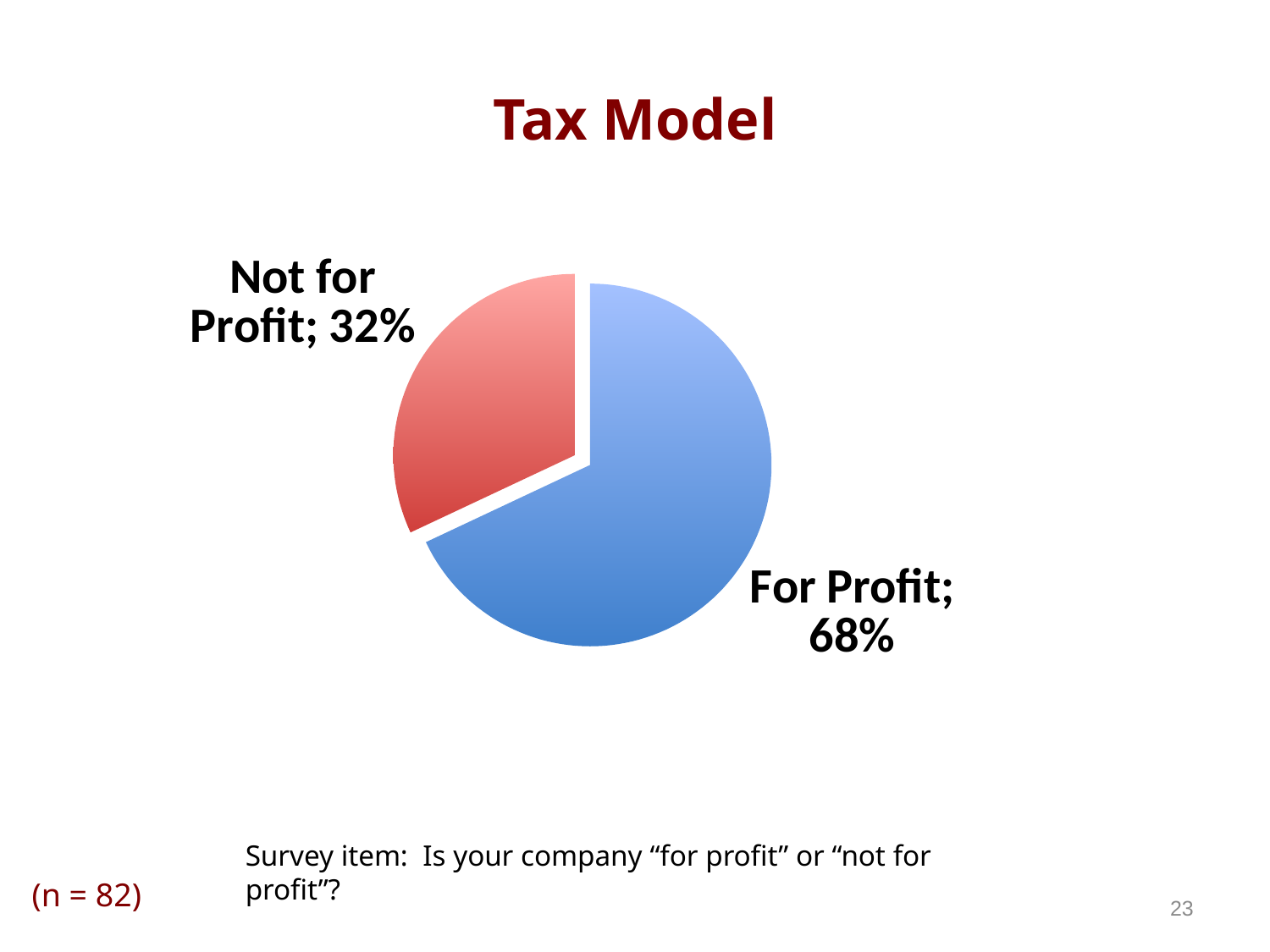
How many slices does the pie chart have? 2 What colour is the For Profit slice? Blue Which slice of the pie is the smallest? Not for Profit What share of the pie is For Profit? 68% What share of the pie is Not for Profit? 32% What is the difference in percentage points between the For Profit and Not for Profit slices? 36 What is the sample size (n) shown on the slide? 82 Which is larger, the For Profit slice or the Not for Profit slice? For Profit What kind of chart is shown on the slide? Pie chart Is the share for Not for Profit greater or less than 50%? less What is the title of the chart? Tax Model Which slice of the pie is the largest? For Profit